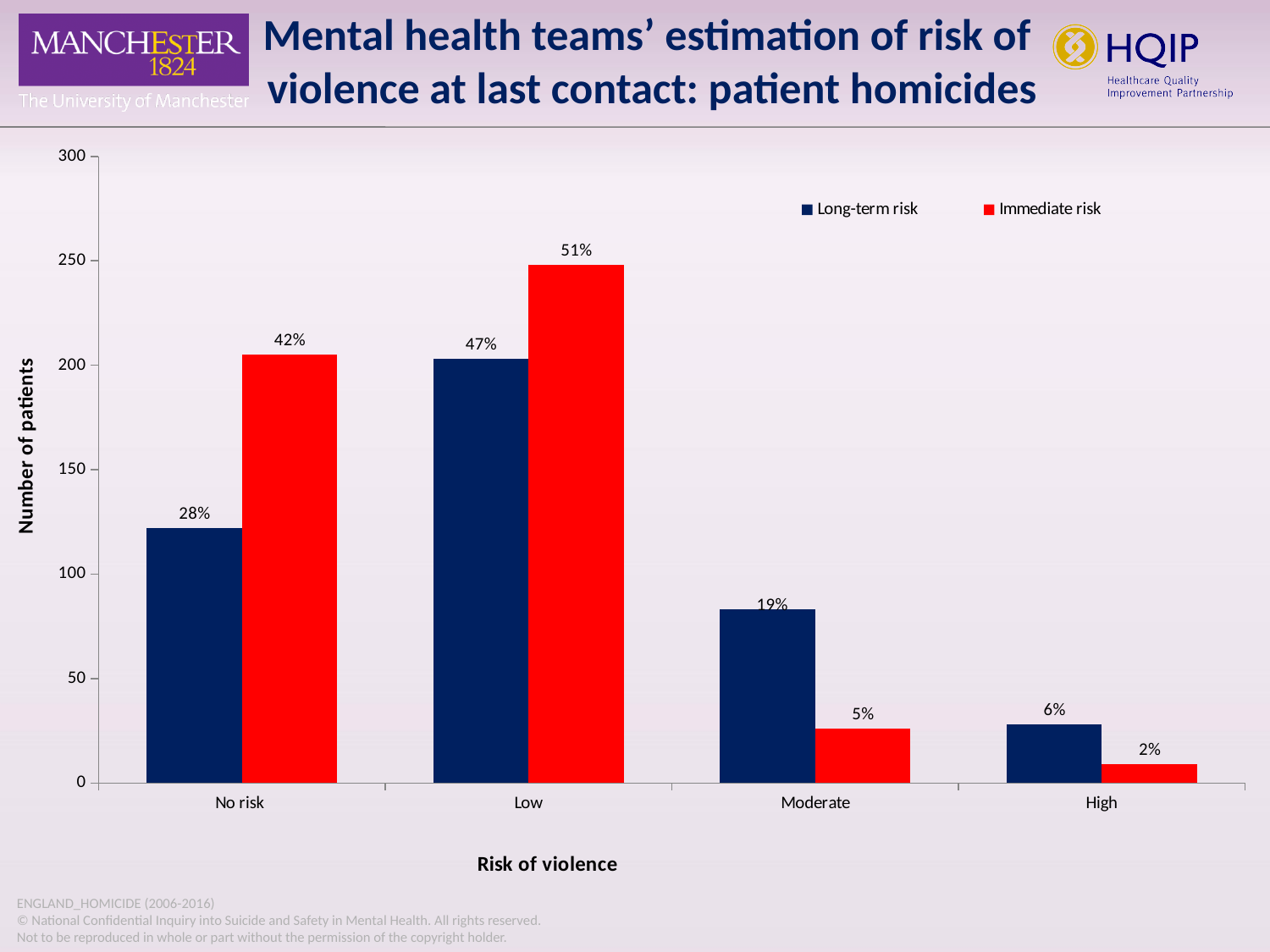
Is the number of patients for the Long-term risk bar in the Moderate category greater or less than 100? less What is the data label on the Immediate risk bar for the Low category? 51% Which risk of violence category has the highest Immediate risk bar? Low Which risk of violence category has the lowest Long-term risk bar? High What is the data label on the Immediate risk bar for the High category? 2% How many series does the legend list? 2 What kind of chart is shown on the slide? Bar chart How many risk of violence categories are shown on the x axis? 4 What is the data label on the Long-term risk bar for the Moderate category? 19% Is the number of patients for the Immediate risk bar in the Low category greater or less than 200? greater For the No risk category, which series has the larger bar: Long-term risk or Immediate risk? Immediate risk What is the data label on the Long-term risk bar for the No risk category? 28%